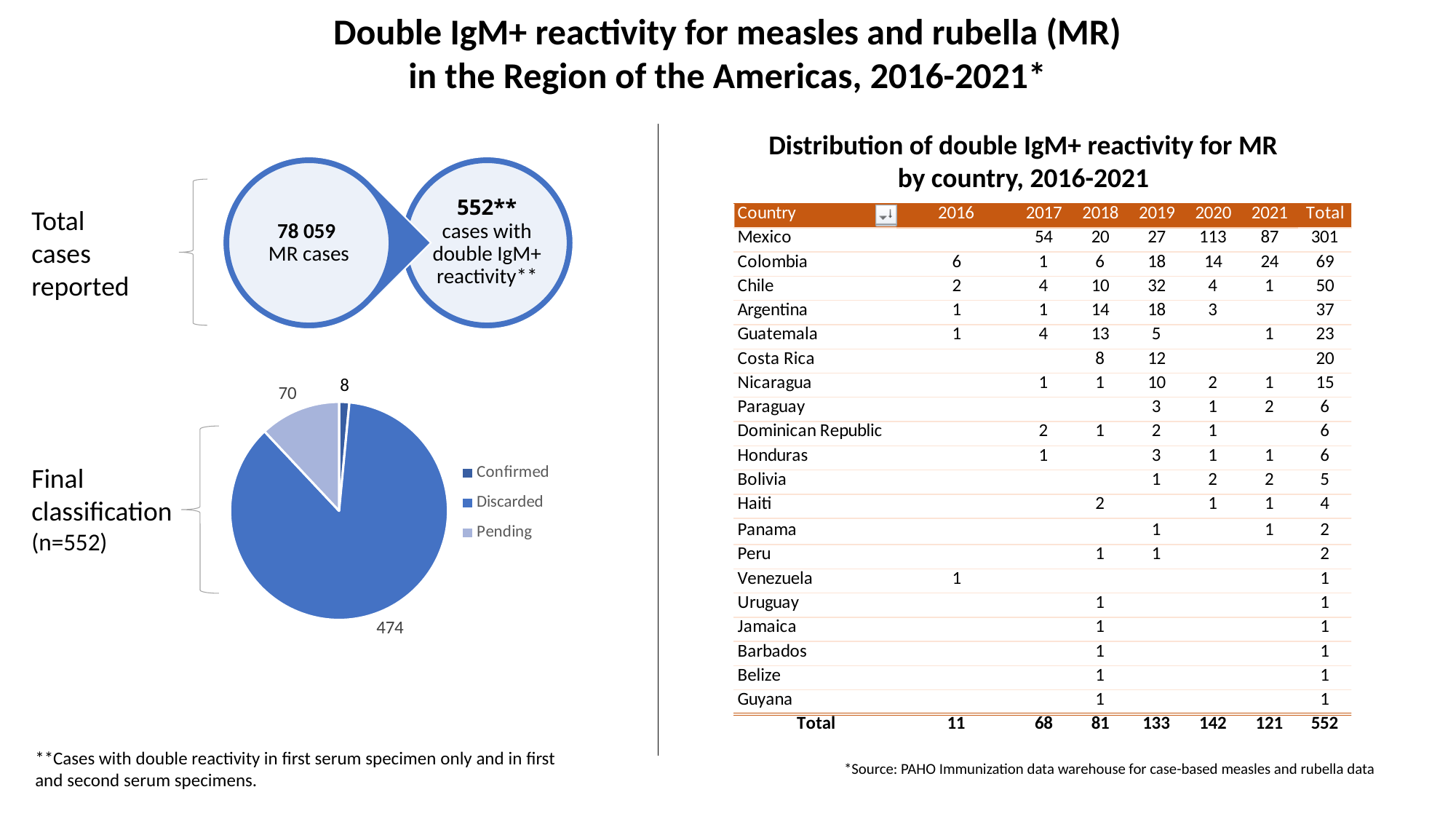
Which category has the smallest slice in the final classification pie chart? Confirmed In the final classification pie chart, how many cases are Confirmed? 8 How many categories does the final classification pie chart show? 3 What is the total of all slices in the final classification pie chart? 552 In the final classification pie chart, which is larger, Pending or Confirmed? Pending In the final classification pie chart, what is the difference between the Discarded and Pending counts? 404 In the final classification pie chart, how many cases are Discarded? 474 What are the legend entries of the final classification pie chart? Confirmed, Discarded, Pending In the final classification pie chart, what is the difference between the Pending and Confirmed counts? 62 In the final classification pie chart, how many cases are Pending? 70 Which category has the largest slice in the final classification pie chart? Discarded What type of chart is used for the final classification (n=552)? pie chart